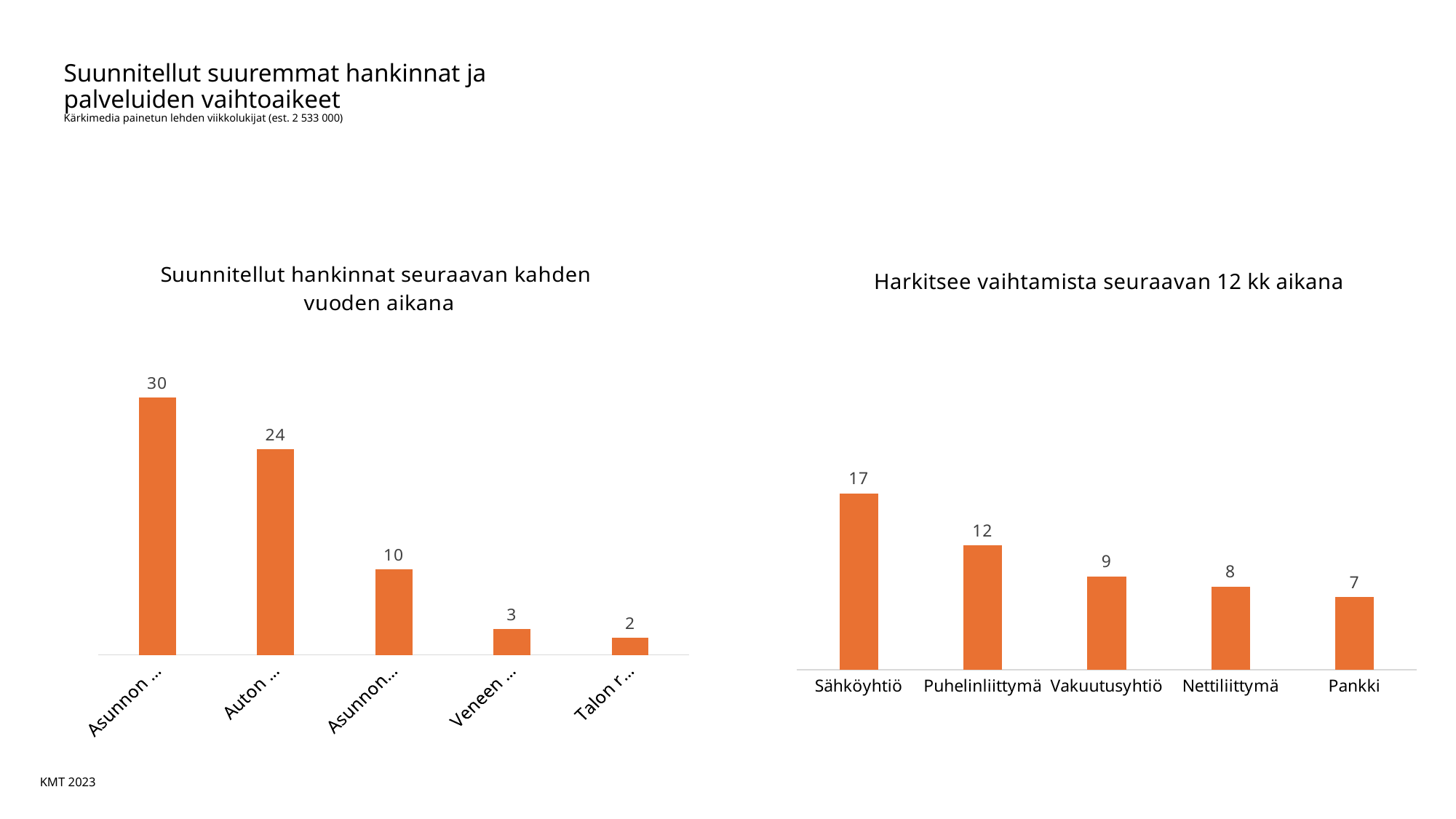
In the chart titled "Harkitsee vaihtamista seuraavan 12 kk aikana", what is the value for Sähköyhtiö? 17 What kind of chart is the chart on the right, titled "Harkitsee vaihtamista seuraavan 12 kk aikana"? bar chart In the chart on the left, titled "Suunnitellut hankinnat seuraavan kahden vuoden aikana", what is the value of the last (rightmost) bar? 2 In the chart titled "Harkitsee vaihtamista seuraavan 12 kk aikana", which category has the highest value? Sähköyhtiö In the chart titled "Harkitsee vaihtamista seuraavan 12 kk aikana", do the values rise or fall from left to right? fall In the chart titled "Harkitsee vaihtamista seuraavan 12 kk aikana", what is the value for Vakuutusyhtiö? 9 In the chart on the left, titled "Suunnitellut hankinnat seuraavan kahden vuoden aikana", what is the difference between the highest and lowest bar values? 28 In the chart titled "Harkitsee vaihtamista seuraavan 12 kk aikana", what is the difference between the values for Sähköyhtiö and Puhelinliittymä? 5 In the chart on the left, titled "Suunnitellut hankinnat seuraavan kahden vuoden aikana", what is the value of the first (leftmost) bar? 30 In the chart titled "Harkitsee vaihtamista seuraavan 12 kk aikana", which category has the lowest value? Pankki In the chart titled "Harkitsee vaihtamista seuraavan 12 kk aikana", which is larger, the value for Nettiliittymä or the value for Pankki? Nettiliittymä In the chart titled "Harkitsee vaihtamista seuraavan 12 kk aikana", how many categories are shown? 5